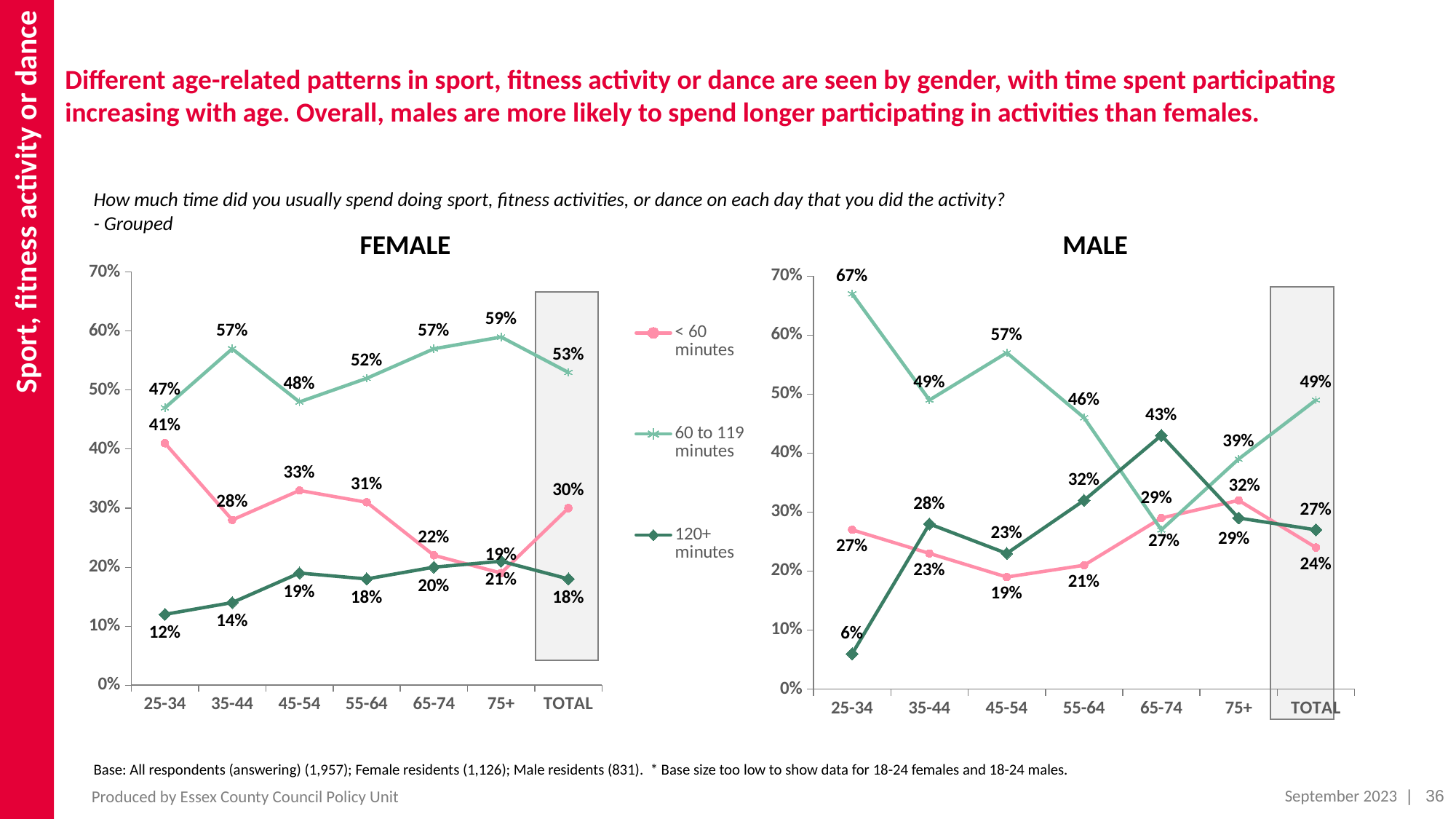
In the MALE chart, what is the value for 60 to 119 minutes among males aged 25-34? 67% In the FEMALE chart, which age group has the highest value for 60 to 119 minutes? 75+ In the FEMALE chart, does the 120+ minutes series generally rise or fall from 25-34 to 65-74? Rise In the FEMALE chart, is the TOTAL value for < 60 minutes greater or less than 20%? greater In the MALE chart, what is the TOTAL value for 120+ minutes? 27% How many age categories (including TOTAL) are shown on the x axis of the MALE chart? 7 In the FEMALE chart, what is the difference between the 60 to 119 minutes value and the < 60 minutes value for the 35-44 age group? 29 percentage points In the MALE chart, which is larger for the 65-74 age group: 120+ minutes or 60 to 119 minutes? 120+ minutes In the MALE chart, which age group has the lowest value for 120+ minutes? 25-34 How many series does the legend list? 3 What type of chart is the FEMALE chart? Line chart In the FEMALE chart, what percentage of females aged 25-34 spent less than 60 minutes? 41%